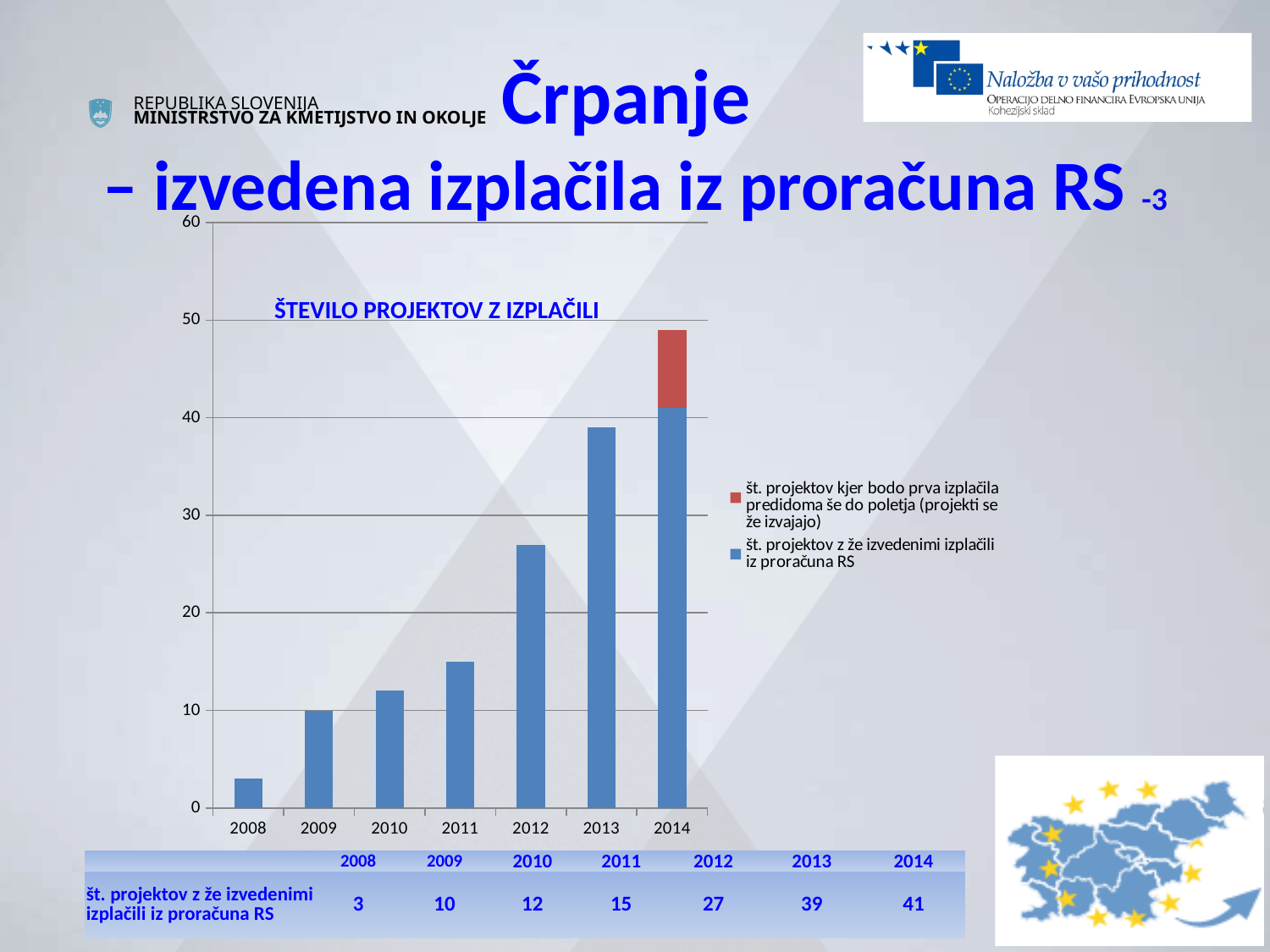
What is the value of the blue series (št. projektov z že izvedenimi izplačili iz proračuna RS) for 2014? 41 Do the values of the series 'št. projektov z že izvedenimi izplačili iz proračuna RS' rise or fall from 2008 to 2014? rise What is the number of projects with already executed payments from the RS budget (št. projektov z že izvedenimi izplačili iz proračuna RS) in 2012? 27 How many years are shown on the x axis of the chart? 7 Is the value for 2010 in the blue series greater or less than 20? less Which year has a larger value for projects with already executed payments: 2011 or 2012? 2012 Which year has the highest number of projects with already executed payments from the RS budget? 2014 Which year has the lowest number of projects with already executed payments from the RS budget? 2008 What is the difference between the 2013 and 2012 values of the series 'št. projektov z že izvedenimi izplačili iz proračuna RS'? 12 What kind of chart is shown on the slide? bar chart What is the value for 2008 in the series 'št. projektov z že izvedenimi izplačili iz proračuna RS'? 3 How many series does the chart legend list? 2